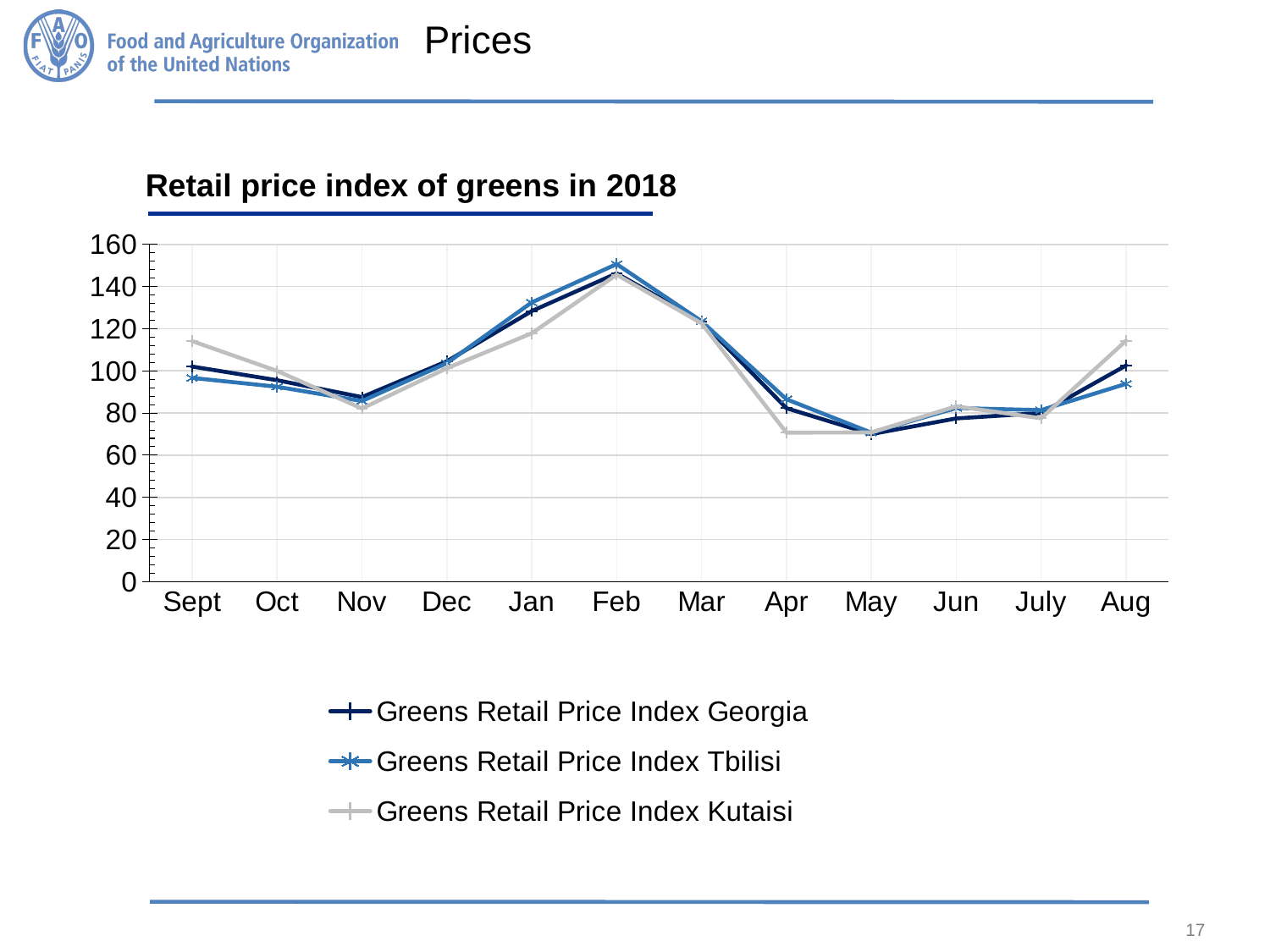
In which month does the Greens Retail Price Index Georgia reach its lowest value? May Is the value for Greens Retail Price Index Georgia in Feb greater or less than 140? greater Is the value for Greens Retail Price Index Kutaisi in Apr greater or less than 80? less In Sept, which is higher: Greens Retail Price Index Kutaisi or Greens Retail Price Index Tbilisi? Greens Retail Price Index Kutaisi What is the title of the chart? Retail price index of greens in 2018 What kind of chart is shown on the slide? Line chart In which month does the Greens Retail Price Index Georgia reach its highest value? Feb Does the Greens Retail Price Index Georgia rise or fall from Feb to May? Fall In which month does the Greens Retail Price Index Kutaisi reach its highest value? Feb How many series does the legend list? 3 Is the value for Greens Retail Price Index Kutaisi in Sept greater or less than 100? greater How many months are plotted along the x axis? 12